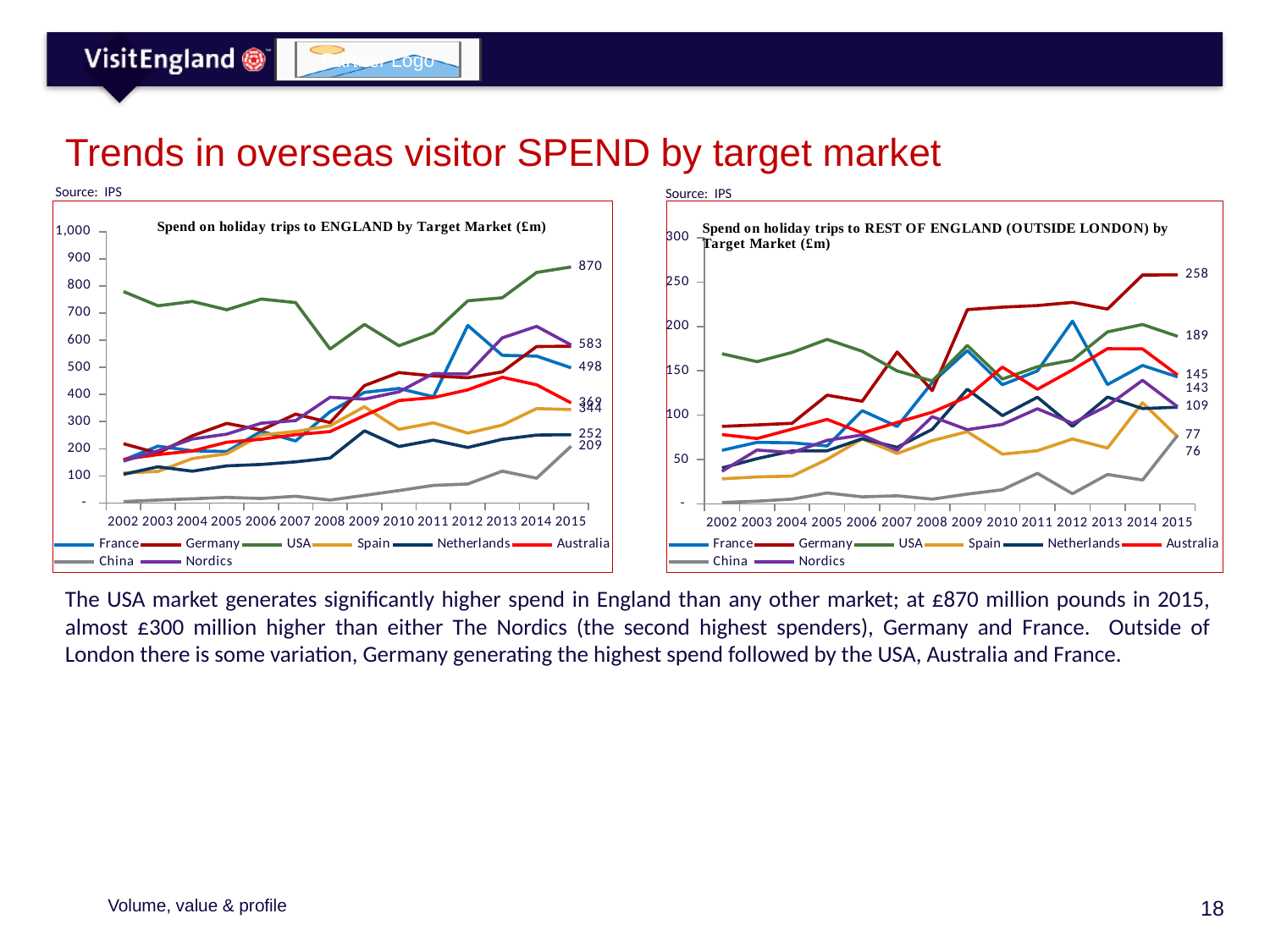
On the left chart (Spend on holiday trips to ENGLAND), which target market has the highest spend in 2015? USA On the left chart (Spend on holiday trips to ENGLAND), which target market has the lowest spend in 2015? China How many years are plotted on the left chart (Spend on holiday trips to ENGLAND)? 14 What kind of chart is the right chart (Spend on holiday trips to REST OF ENGLAND)? Line chart On the right chart (Spend on holiday trips to REST OF ENGLAND), what is the difference between the 2015 values for Germany and USA? 69 On the right chart (Spend on holiday trips to REST OF ENGLAND), what is the value for Germany in 2015? 258 On the left chart (Spend on holiday trips to ENGLAND), is the value for USA in 2002 greater or less than 700? greater On the left chart (Spend on holiday trips to ENGLAND), what is the difference between the 2015 values for USA and France? 372 On the left chart (Spend on holiday trips to ENGLAND), which is larger in 2015, France or Netherlands? France On the left chart (Spend on holiday trips to ENGLAND), what is the value for USA in 2015? 870 How many series does the legend of the left chart (Spend on holiday trips to ENGLAND) list? 8 On the right chart (Spend on holiday trips to REST OF ENGLAND), does the Germany line generally rise or fall from 2002 to 2015? Rise